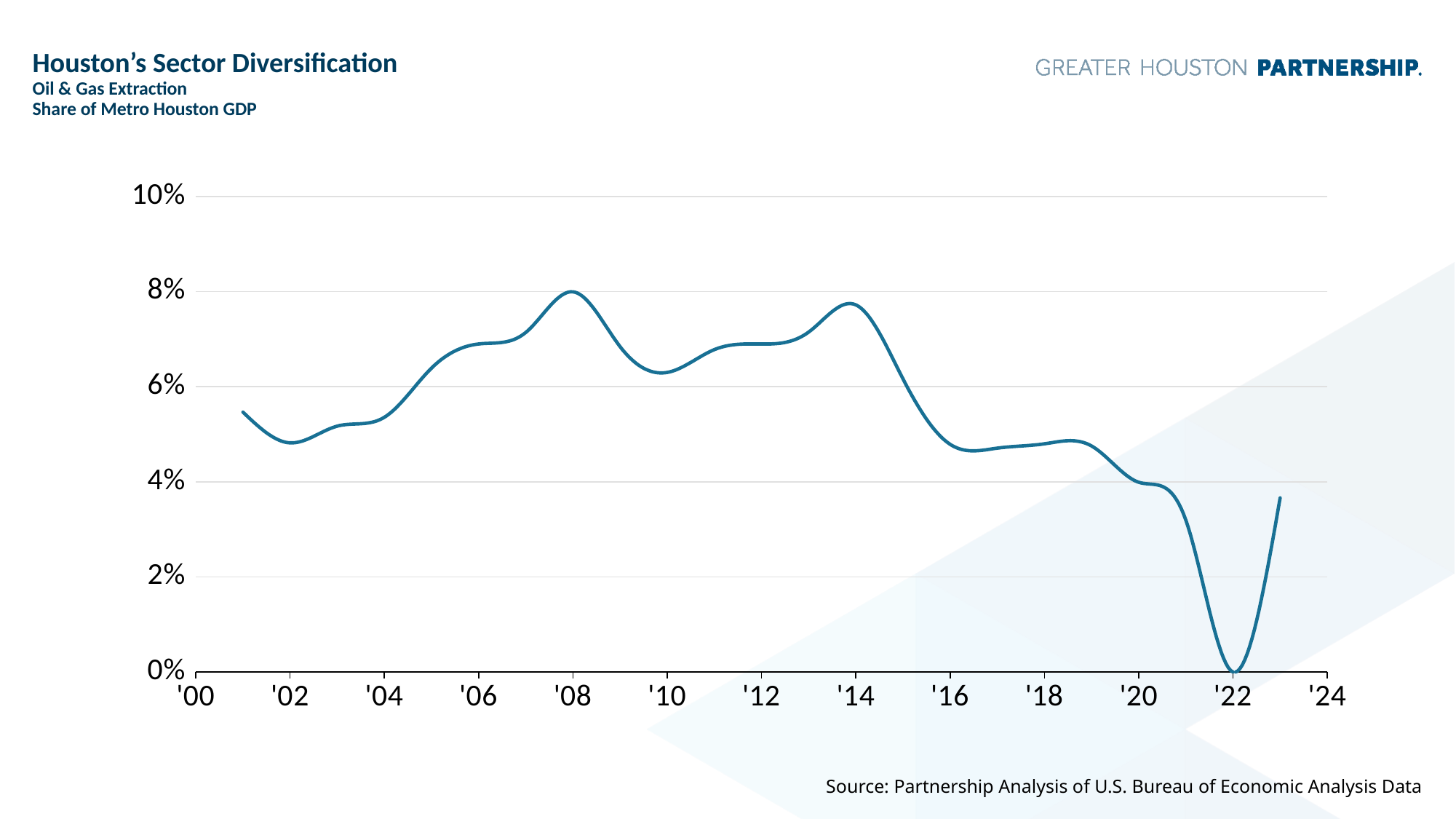
What is the title of the chart? Houston's Sector Diversification Does the line rise or fall between '14 and '22? fall Is the value for '10 greater or less than 6%? greater In which year does the line reach its lowest point? '22 What value does the line reach in '22? 0% Which year has the larger value, '08 or '16? '08 What kind of chart is shown on the slide? line chart Is the value for '23 greater or less than 4%? less In which year does the line reach its highest point? '08 Is the value for '02 greater or less than 6%? less What does the chart measure, according to the subtitle? Oil & Gas Extraction share of Metro Houston GDP